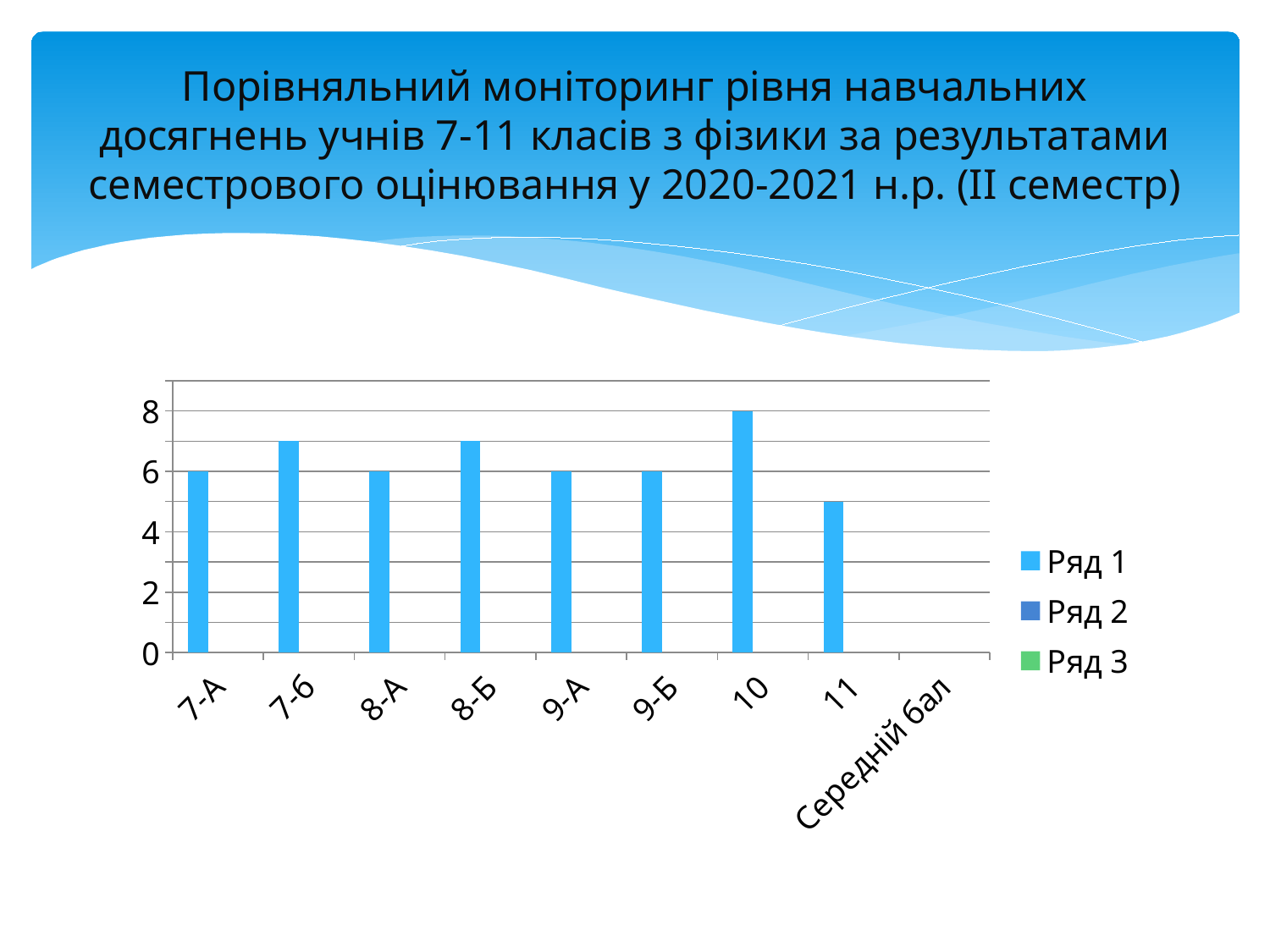
How many categories are shown on the x axis? 9 What is the value for 9-Б? 6 Is the value for 8-Б greater or less than 6? greater What is the difference between the values for 10 and 7-А? 2 How many series does the legend list? 3 Which category has the highest value? 10 What is the value for 7-А? 6 Among the categories with a bar, which has the lowest value? 11 What kind of chart is shown on the slide? bar chart What is the value for 10? 8 Which is larger, the value for 7-Б or the value for 7-А? 7-Б Is the value for 11 greater or less than 6? less